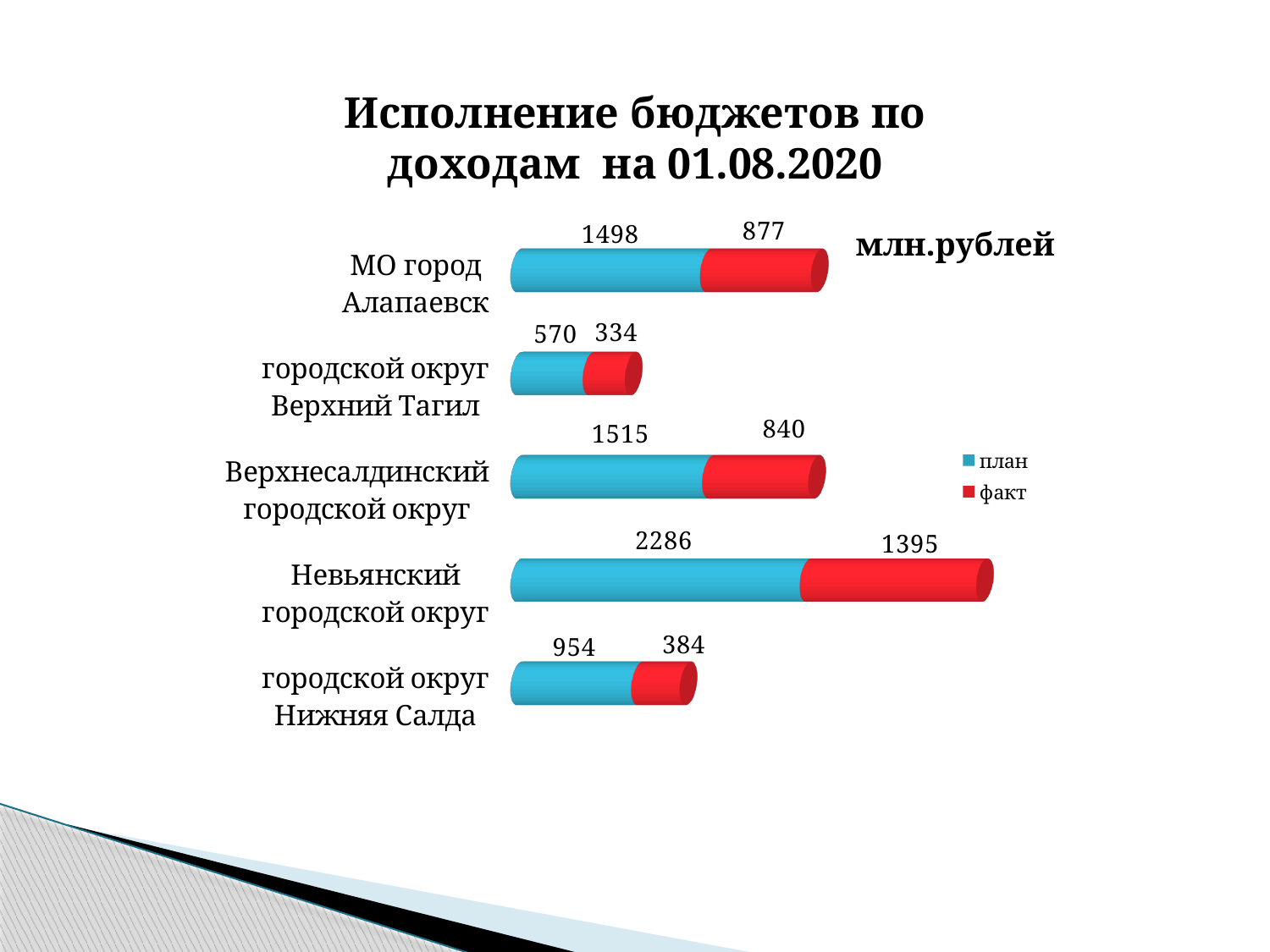
Which category has the lowest факт value? городской округ Верхний Тагил What is the факт value for городской округ Верхний Тагил? 334 What unit is indicated for the values in the chart? млн.рублей How many categories are shown in the chart? 5 What is the факт value for МО город Алапаевск? 877 What is the план value for Невьянский городской округ? 2286 What kind of chart is shown on the slide? bar chart Which is larger, the факт value for МО город Алапаевск or the факт value for Верхнесалдинский городской округ? МО город Алапаевск What is the difference between the план and факт values for Верхнесалдинский городской округ? 675 Which category has the highest план value? Невьянский городской округ How many series does the legend list? 2 What is the план value for городской округ Нижняя Салда? 954